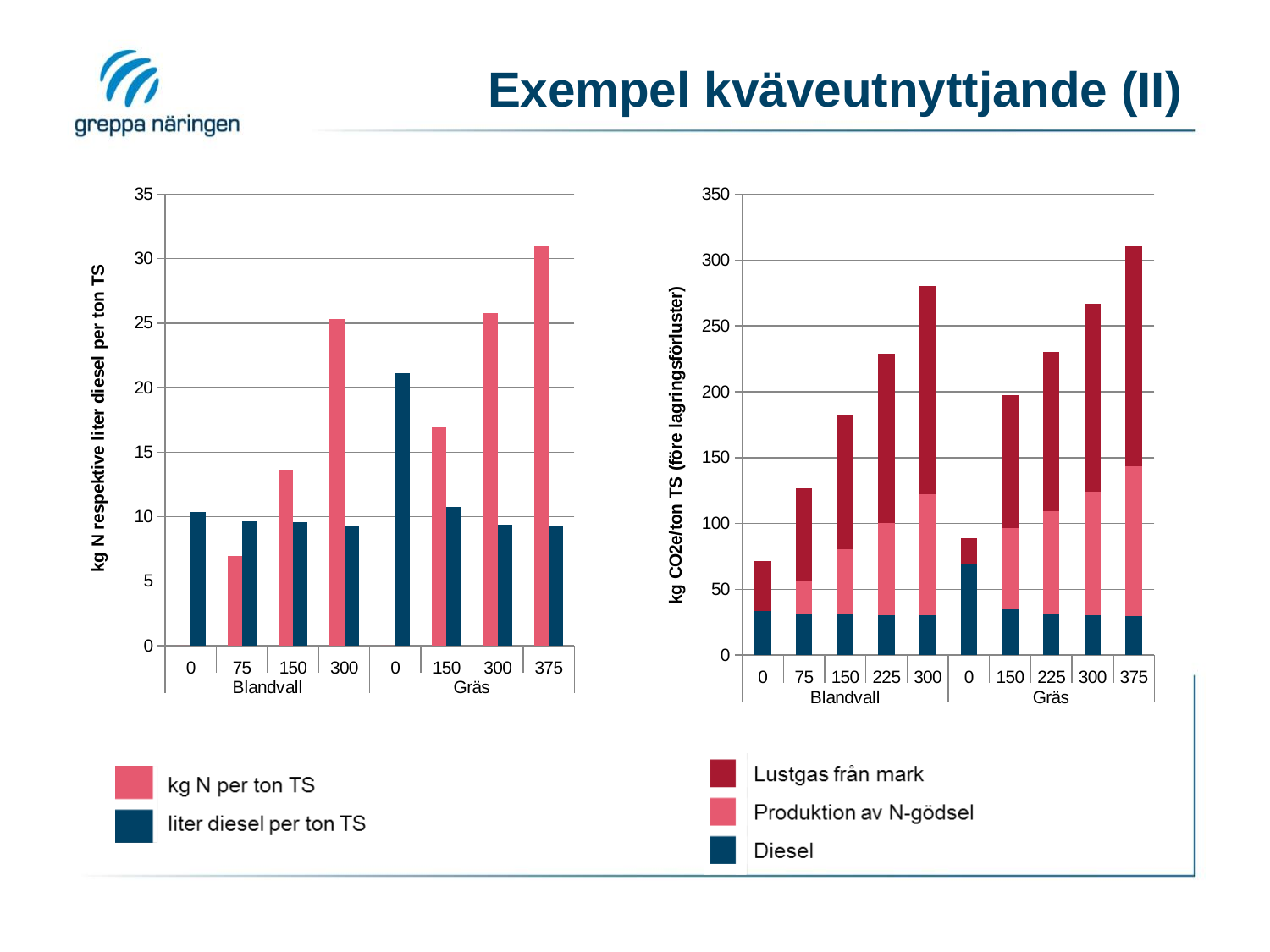
On the right chart, is the total for Gräs 375 greater or less than 300? greater On the left chart, which category has the highest value for kg N per ton TS? Gräs 375 On the left chart, which category has the highest value for liter diesel per ton TS? Gräs 0 On the left chart, is the kg N per ton TS value for Blandvall 75 greater or less than 10? less On the left chart, is the liter diesel per ton TS value for Gräs 0 greater or less than 20? greater On the right chart, how many bars (categories) are plotted in total? 10 On the right chart, which category has the tallest stacked bar? Gräs 375 On the left chart, which is larger: liter diesel per ton TS for Gräs 0 or for Blandvall 0? Gräs 0 On the left chart, what kind of chart is shown? bar chart On the left chart, how many series does the legend list? 2 On the right chart, do the stacked bar totals rise or fall as the N rate increases within Blandvall? rise On the right chart, how many series does the legend list? 3